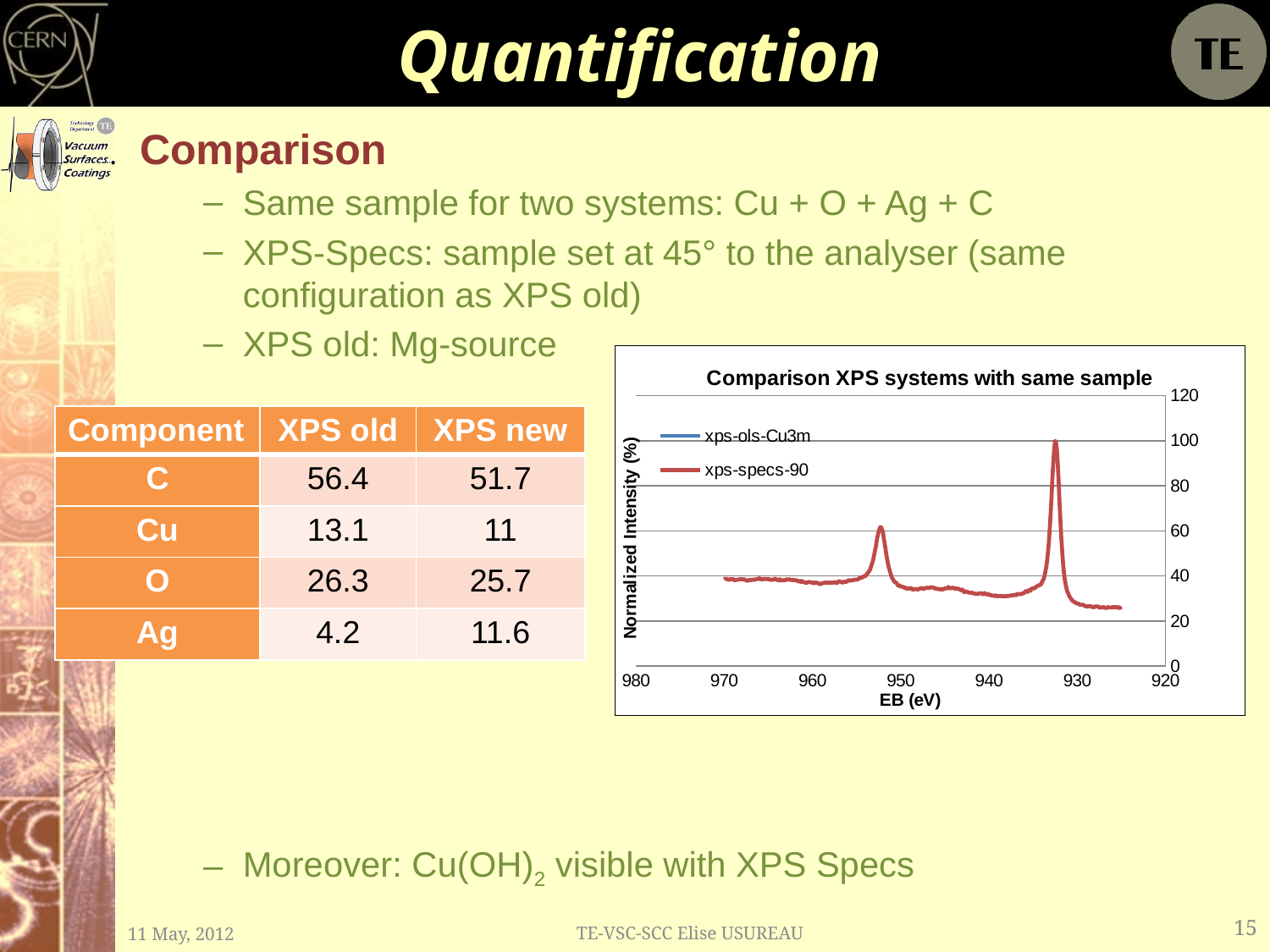
Is the value of the spectrum at 940 eV greater or less than 60? less Is the peak value of the spectrum near 932 eV greater or less than 80? greater What is the title of the chart? Comparison XPS systems with same sample What is the label of the x axis of the chart? EB (eV) Is the value of the spectrum at 970 eV greater or less than 60? less Which peak is higher: the one near 952 eV or the one near 932 eV? the one near 932 eV How many series does the chart legend list? 2 What is the highest value shown on the y axis of the chart? 120 What kind of chart is shown on the slide? line chart